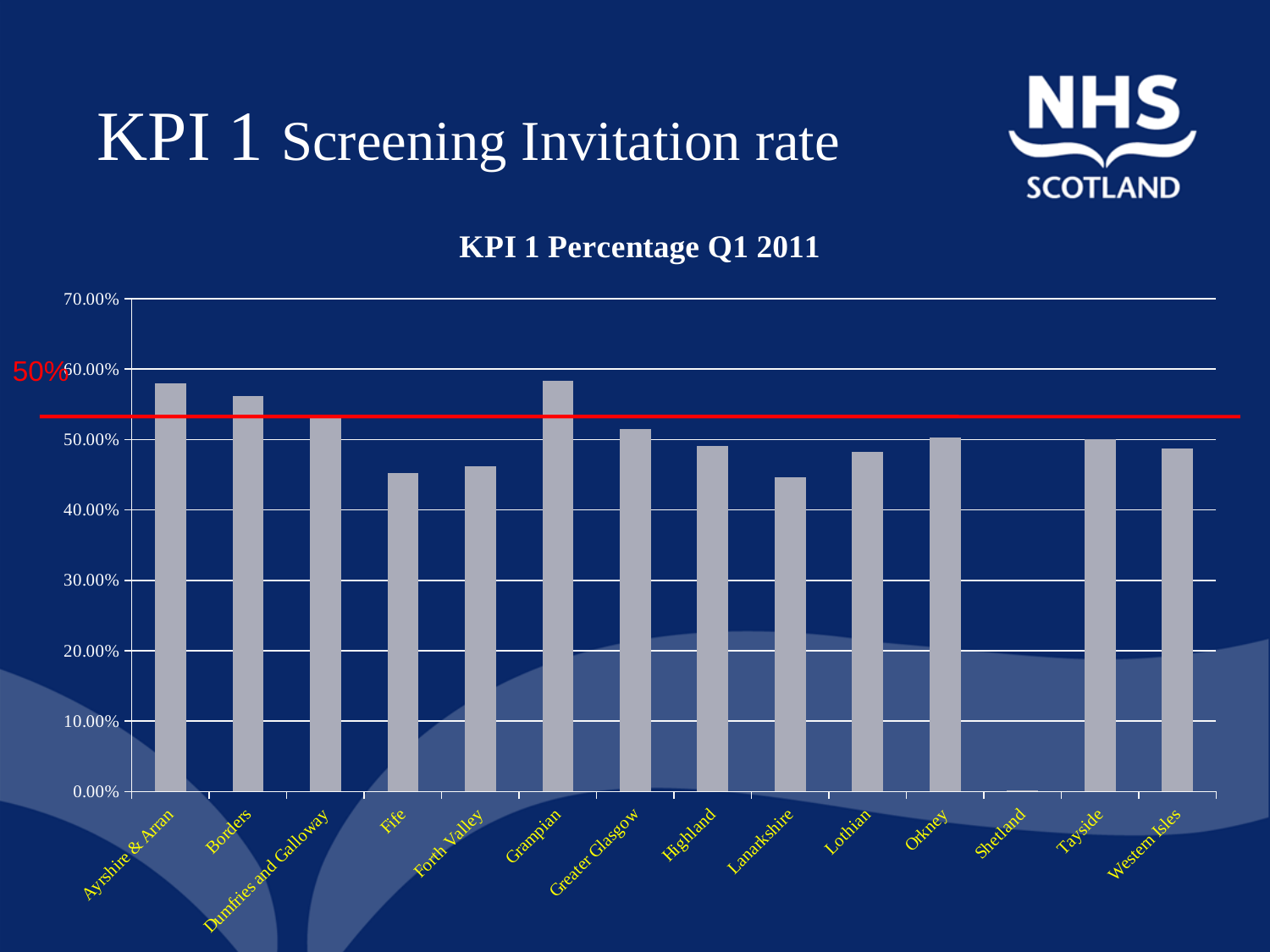
What type of chart is shown on the slide? bar chart What is the highest value shown on the y axis of the chart? 70.00% Is the value for Forth Valley greater or less than 50.00%? less Which category has the lowest value in the chart? Shetland Is the value for Ayrshire & Arran greater or less than 50.00%? greater Is the value for Grampian greater or less than 50.00%? greater What is the title of the chart? KPI 1 Percentage Q1 2011 Which has the larger value, Ayrshire & Arran or Fife? Ayrshire & Arran How many health boards (categories) are shown on the x axis of the chart? 14 Which has the larger value, Borders or Lanarkshire? Borders